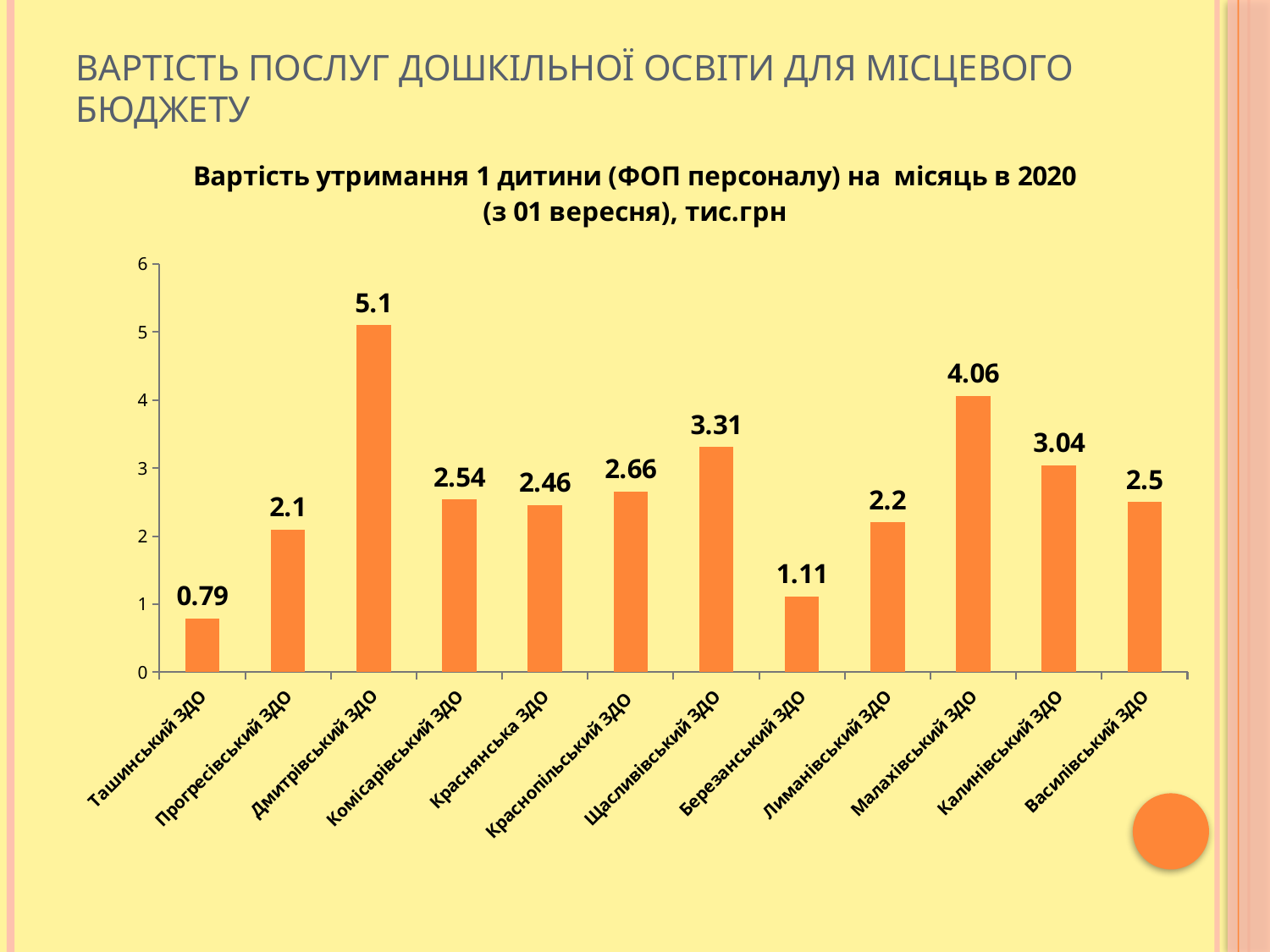
Is the value for Василівський ЗДО greater or less than 2? greater Which category has the lowest value? Ташинський ЗДО Which category has the highest value? Дмитрівський ЗДО What is the title of the chart? Вартість утримання 1 дитини (ФОП персоналу) на місяць в 2020 (з 01 вересня), тис.грн What is the value for Малахівський ЗДО? 4.06 What kind of chart is shown on the slide? bar chart What is the difference between the values for Щасливівський ЗДО and Лиманівський ЗДО? 1.11 What is the difference between the values for Дмитрівський ЗДО and Малахівський ЗДО? 1.04 What is the value for Дмитрівський ЗДО? 5.1 Which is larger, the value for Калинівський ЗДО or the value for Краснопільський ЗДО? Калинівський ЗДО How many categories are shown on the x axis? 12 What is the value for Березанський ЗДО? 1.11